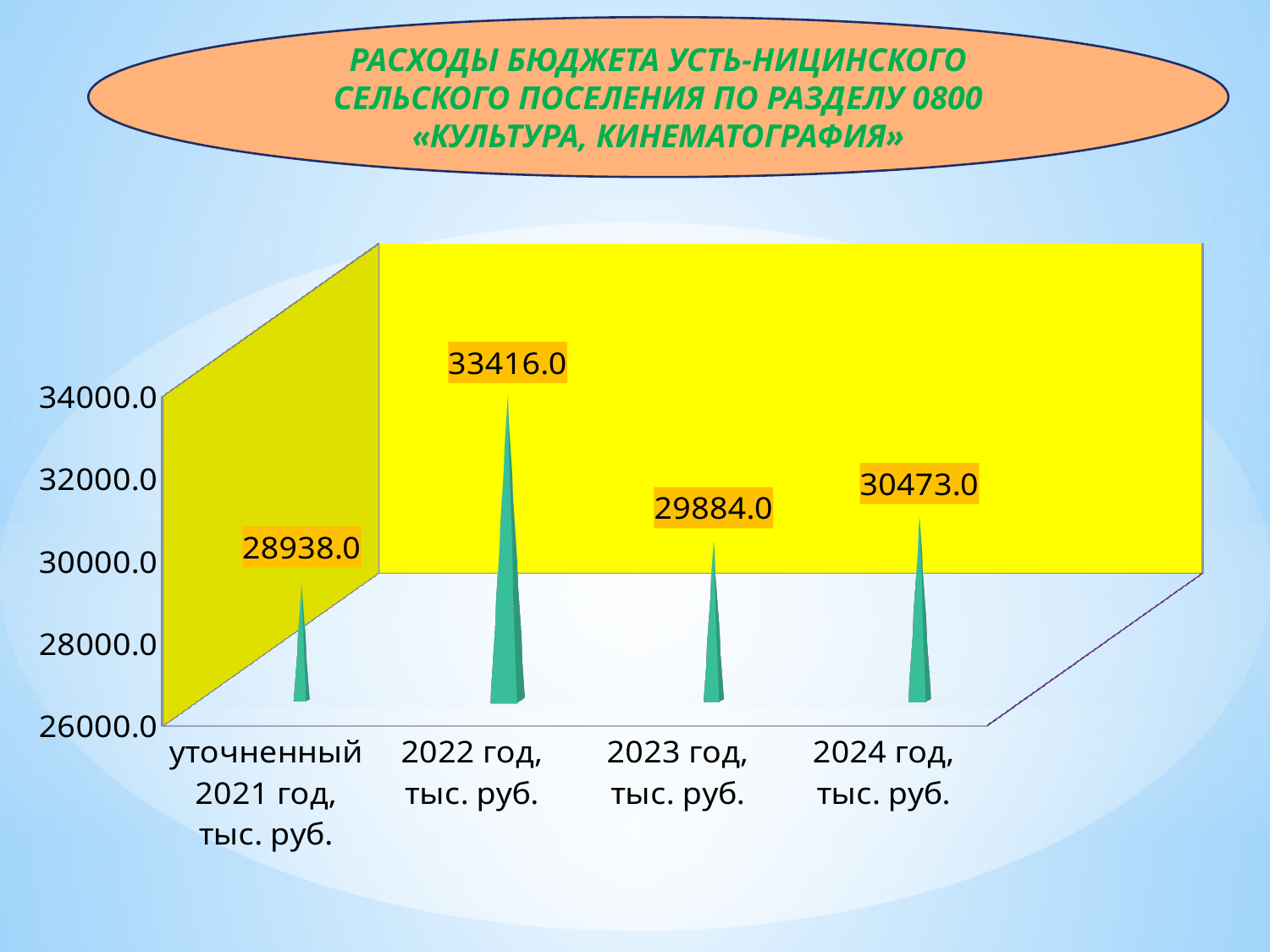
Which category has the highest value? 2022 год, тыс. руб. What is the difference between the values for 2022 год and 2023 год? 3532.0 How many categories are shown on the x axis? 4 What kind of chart is shown on the slide? bar chart Which is larger, the value for 2023 год or the value for 2024 год? 2024 год, тыс. руб. What is the value for 2024 год, тыс. руб.? 30473.0 What is the value for уточненный 2021 год, тыс. руб.? 28938.0 What is the value for 2023 год, тыс. руб.? 29884.0 Which category has the lowest value? уточненный 2021 год, тыс. руб. What is the value for 2022 год, тыс. руб.? 33416.0 What is the difference between the values for 2024 год and уточненный 2021 год? 1535.0 What is the title of the chart on the slide? РАСХОДЫ БЮДЖЕТА УСТЬ-НИЦИНСКОГО СЕЛЬСКОГО ПОСЕЛЕНИЯ ПО РАЗДЕЛУ 0800 «КУЛЬТУРА, КИНЕМАТОГРАФИЯ»